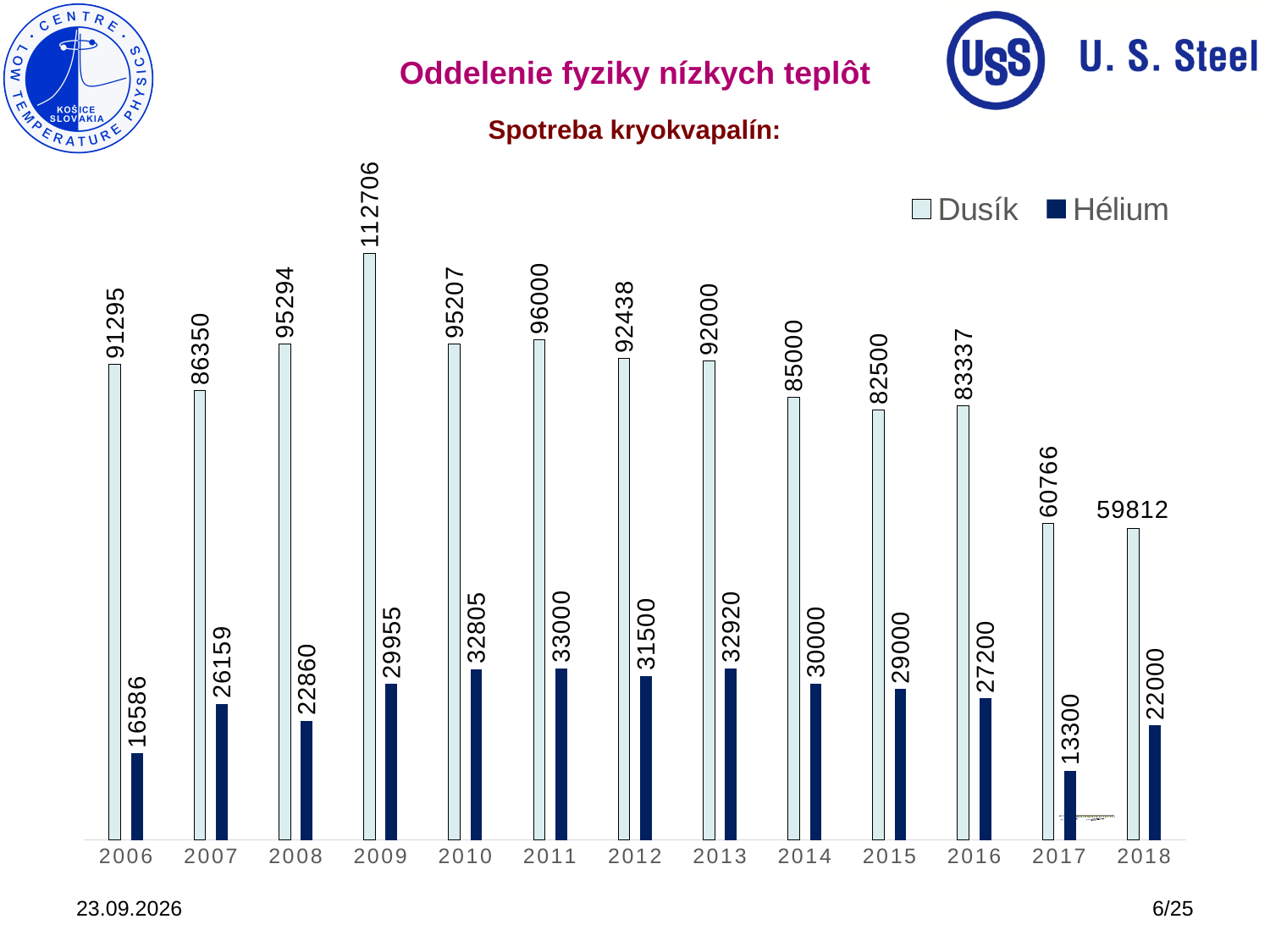
Which year has the lowest Dusík value? 2018 What is the Hélium value for 2013? 32920 How many series does the legend list? 2 Which year has the highest Dusík value? 2009 How many years are shown on the x axis? 13 What kind of chart is shown on the slide? bar chart What is the difference between the Dusík and Hélium values in 2009? 82751 What is the Dusík value for 2009? 112706 What is the Dusík value for 2018? 59812 Which year has the lowest Hélium value? 2017 Which is larger, the Hélium value in 2010 or in 2016? 2010 By how much did the Hélium value increase from 2017 to 2018? 8700